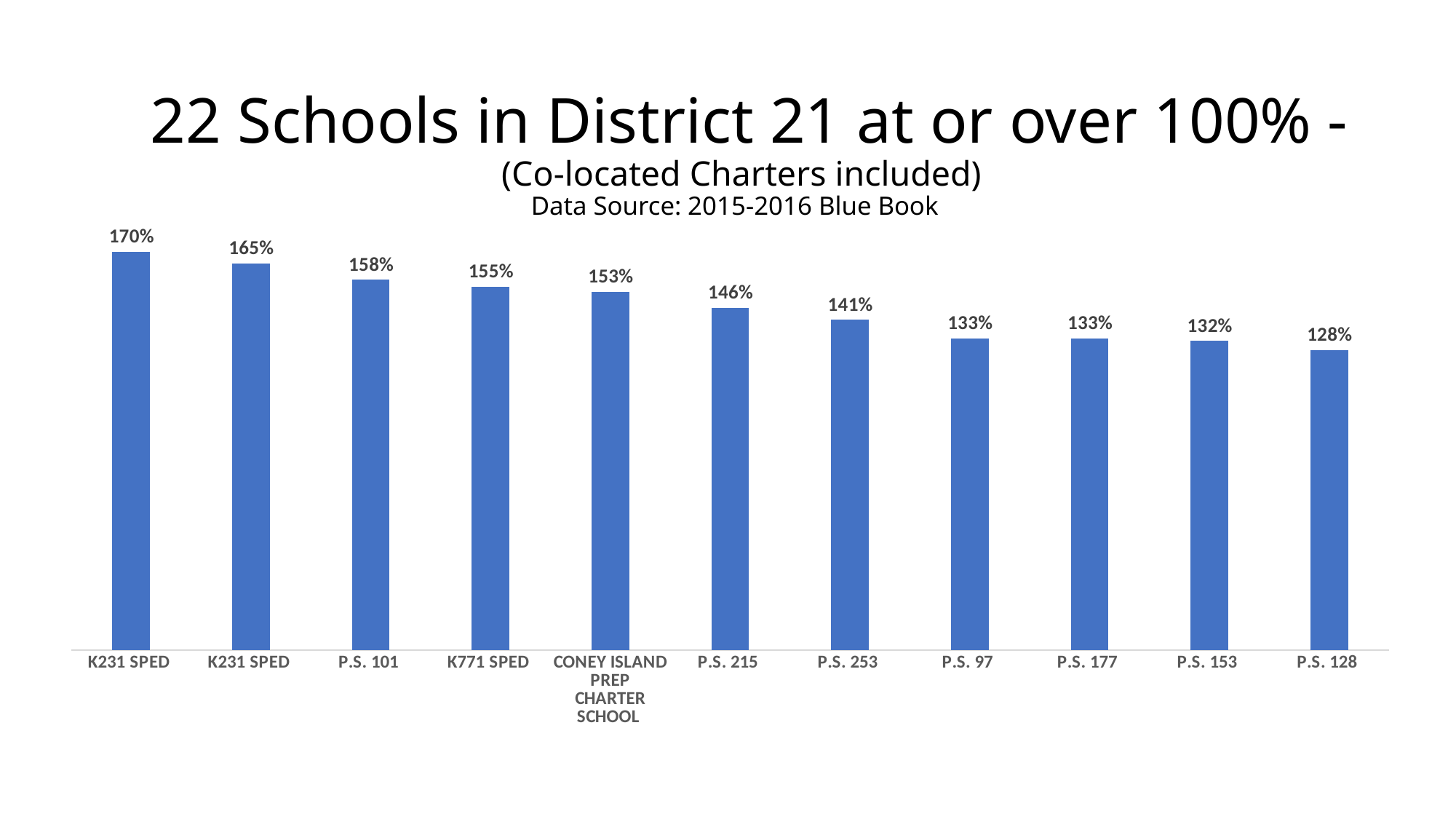
What is the difference between the values for P.S. 215 and P.S. 153? 14% What is the value for Coney Island Prep Charter School? 153% Do the values rise or fall from left to right across the chart? Fall What is the value for P.S. 253? 141% How many bars are shown on the chart? 11 Which is larger, the value for P.S. 101 or the value for P.S. 97? P.S. 101 What kind of chart is shown on the slide? Bar chart What is the highest value shown on the chart? 170% What data source is cited under the chart title? 2015-2016 Blue Book What is the value for K771 SPED? 155% What is the value for P.S. 101? 158% Which school has the lowest value on the chart? P.S. 128